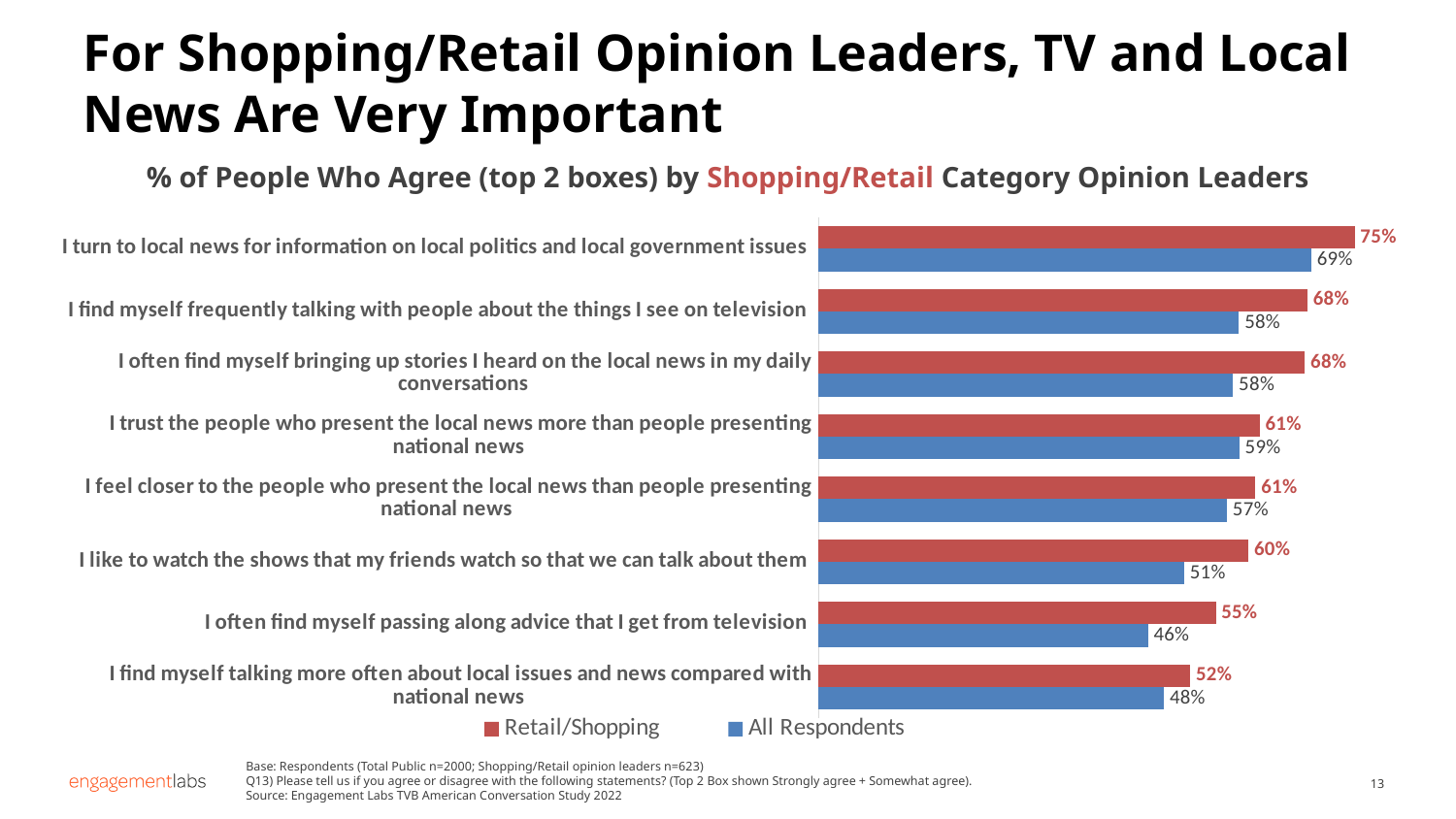
What is the All Respondents value for "I trust the people who present the local news more than people presenting national news"? 59% What percentage of All Respondents agree with "I often find myself passing along advice that I get from television"? 46% What percentage of Retail/Shopping opinion leaders agree with "I turn to local news for information on local politics and local government issues"? 75% What type of chart is shown on the slide? Bar chart Which colour represents the Retail/Shopping series in the chart? Red Which statement has the lowest agreement among All Respondents? I often find myself passing along advice that I get from television How many statements are shown in the chart? 8 What is the difference between Retail/Shopping and All Respondents for "I find myself frequently talking with people about the things I see on television"? 10 percentage points How many series does the legend list? 2 What is the difference between Retail/Shopping and All Respondents for "I often find myself passing along advice that I get from television"? 9 percentage points Which statement has the highest agreement among Retail/Shopping opinion leaders? I turn to local news for information on local politics and local government issues For "I like to watch the shows that my friends watch so that we can talk about them", which group has the higher value: Retail/Shopping or All Respondents? Retail/Shopping